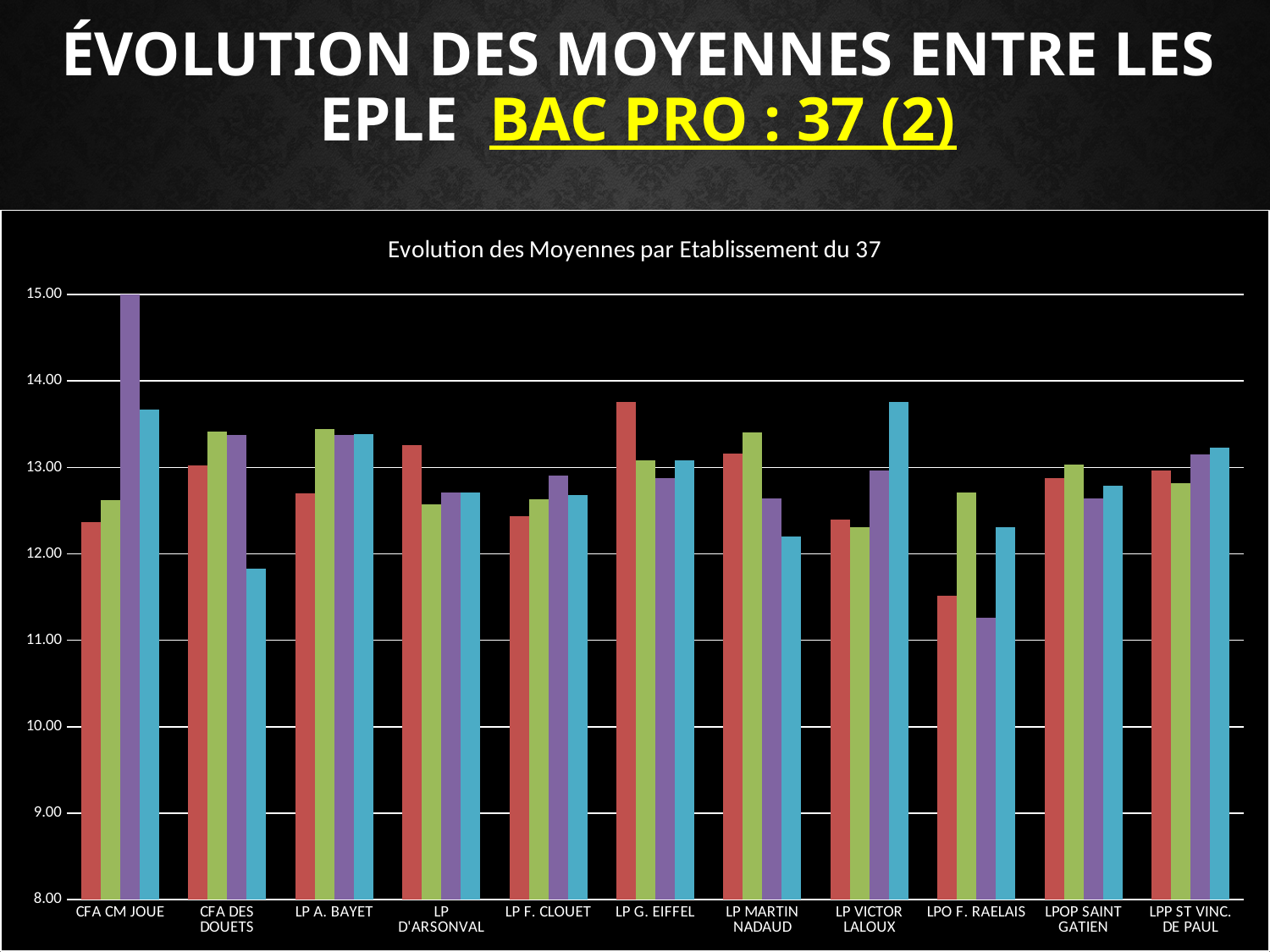
What is the title of the chart? Evolution des Moyennes par Etablissement du 37 Which establishment has the tallest bar in the chart? CFA CM JOUE What kind of chart is shown on the slide? Bar chart Which establishment has the shortest bar in the chart? LPO F. RAELAIS Is the value of the blue bar for LP VICTOR LALOUX greater or less than 13.00? greater Which has the larger red bar, CFA CM JOUE or CFA DES DOUETS? CFA DES DOUETS How many bars are plotted for each establishment in the chart? 4 Is the value of the purple bar for LPO F. RAELAIS greater or less than 12.00? less How many establishments (categories) are shown on the x axis of the chart? 11 Is the value of the purple bar for CFA CM JOUE greater or less than 14.00? greater